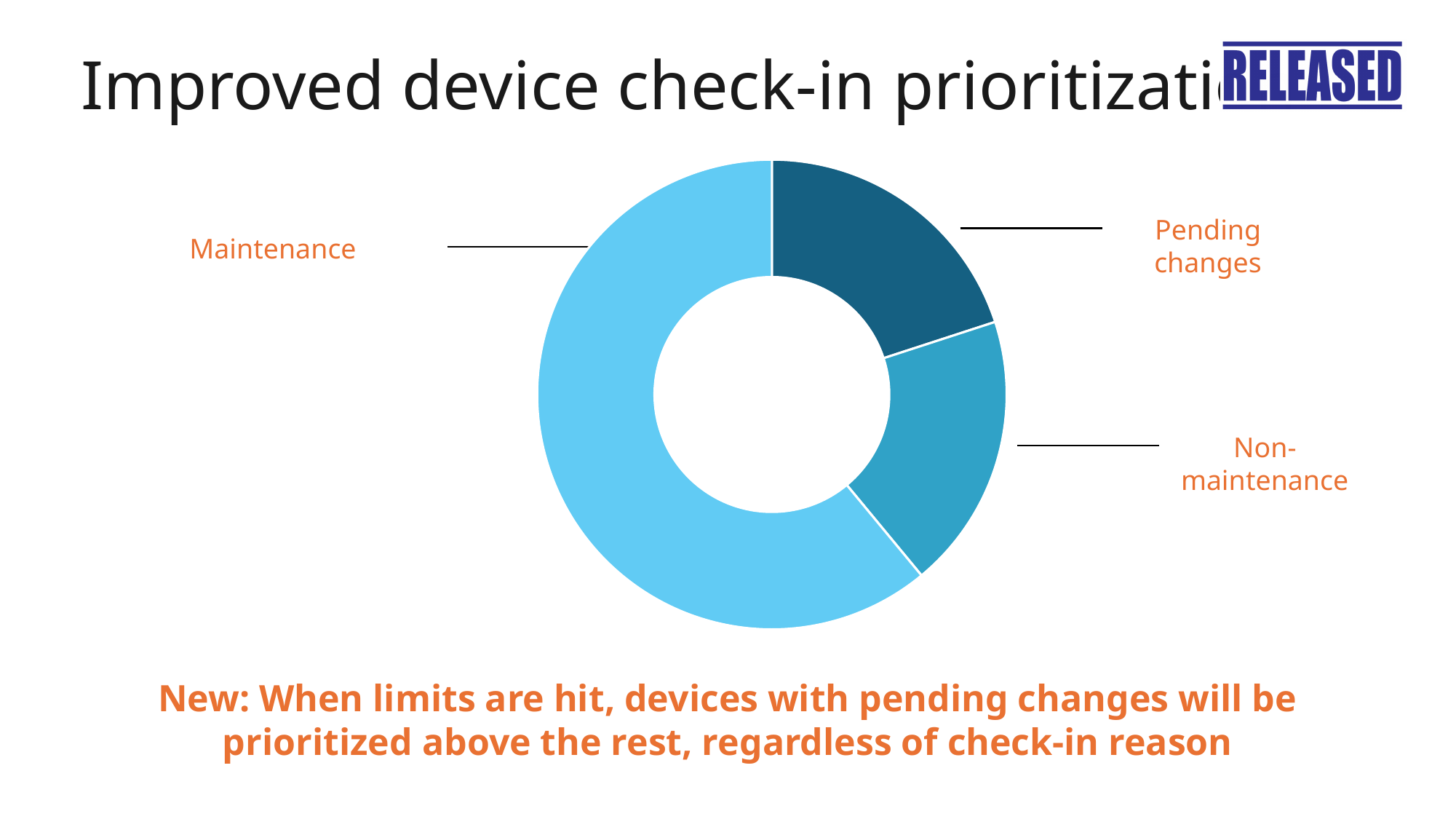
Which category is shown in the darkest blue slice? Pending changes Does the Maintenance slice take up more or less than half of the donut chart? more What kind of chart is shown on the slide? Pie chart (donut) Which slice is larger, Maintenance or Non-maintenance? Maintenance How many slices does the donut chart have? 3 Which category has the largest slice in the donut chart? Maintenance What is the title of the slide containing the donut chart? Improved device check-in prioritization What are the three categories labelled on the donut chart? Maintenance, Pending changes, Non-maintenance Which slice is larger, Maintenance or Pending changes? Maintenance